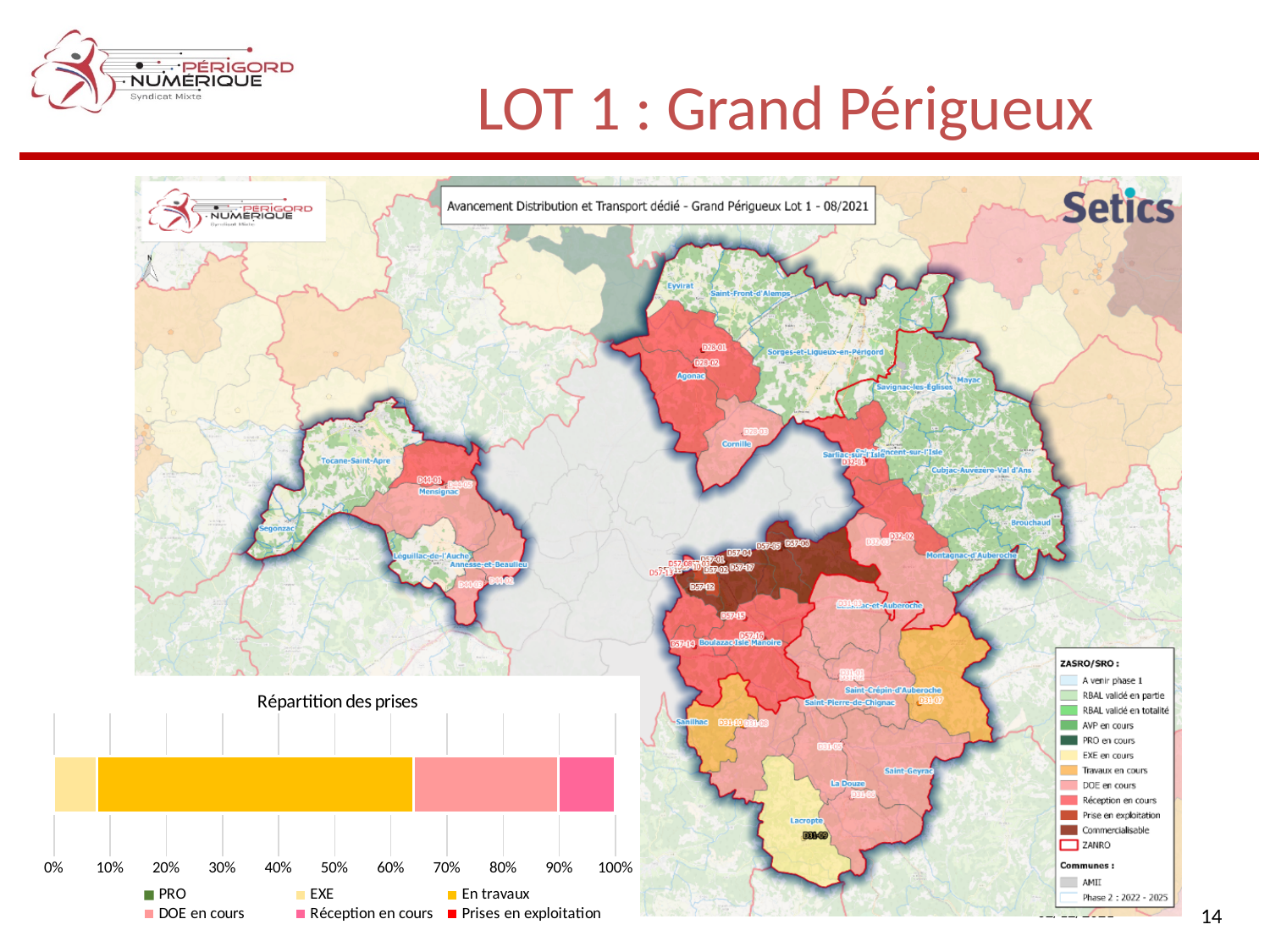
In the "Répartition des prises" chart, is the share for En travaux greater or less than 50%? greater In the "Répartition des prises" chart, is the share for Réception en cours greater or less than 20%? less What kind of chart is the "Répartition des prises" chart? Stacked bar chart How many series does the legend of the "Répartition des prises" chart list? 6 In the "Répartition des prises" chart, which series occupies the largest share of the bar? En travaux What is the title of the bar chart on the slide? Répartition des prises What is the highest value shown on the x axis of the "Répartition des prises" chart? 100% In the "Répartition des prises" chart, is the share for EXE greater or less than 10%? less In the "Répartition des prises" chart, which is larger: the share for En travaux or the share for DOE en cours? En travaux In the "Répartition des prises" chart, which is larger: the share for DOE en cours or the share for Réception en cours? DOE en cours